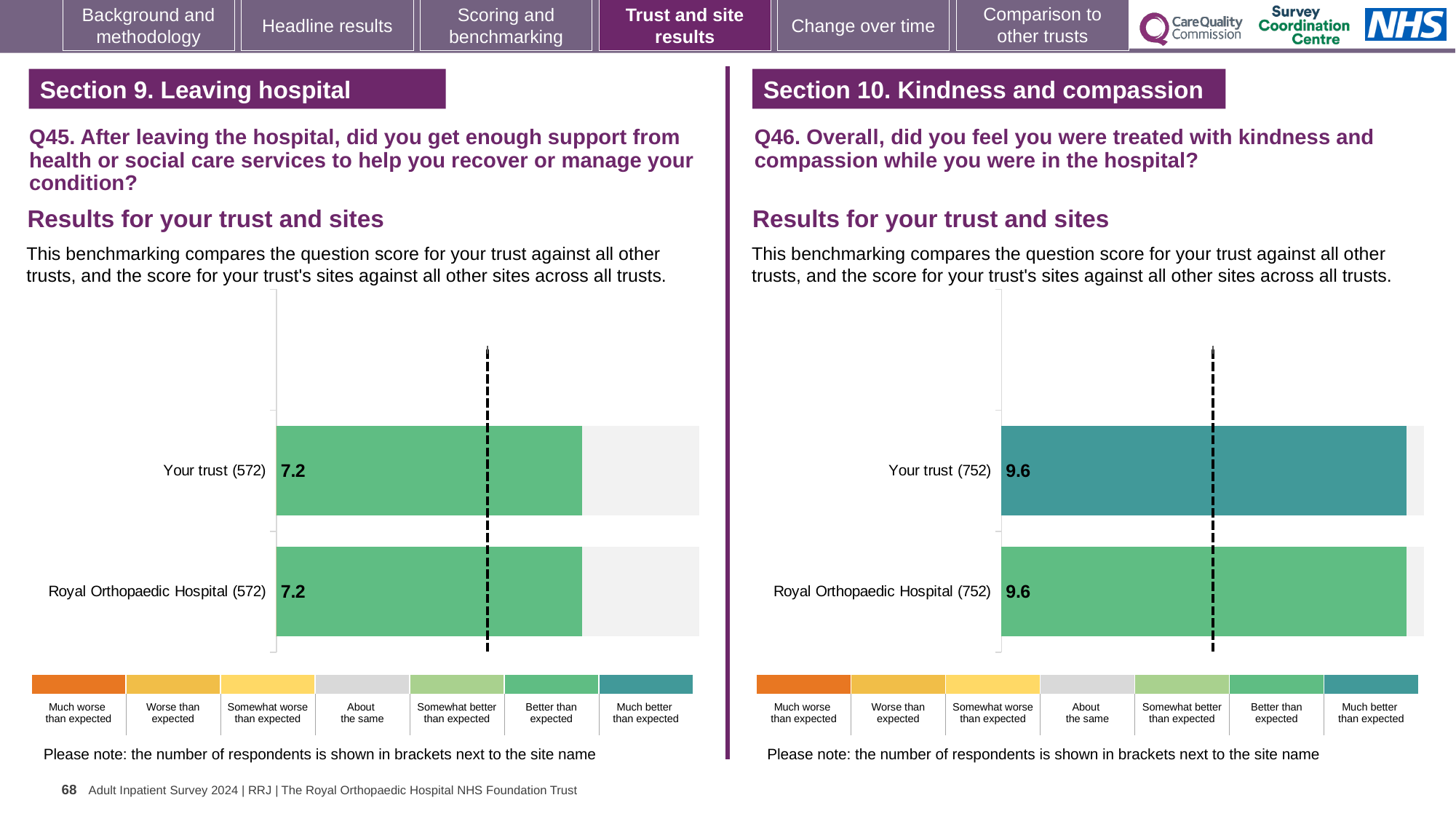
In the Q45 chart on the left, what is the score for Your trust (572)? 7.2 In the Q45 chart on the left, what is the score for Royal Orthopaedic Hospital (572)? 7.2 In the Q45 chart on the left, how many respondents are shown in brackets next to Royal Orthopaedic Hospital? 572 How many bars are plotted in the Q46 chart on the right? 2 In the Q46 chart on the right, how many respondents are shown in brackets next to Your trust? 752 How many bars are plotted in the Q45 chart on the left? 2 In the Q46 chart on the right, what is the score for Your trust (752)? 9.6 In the Q45 chart on the left, what is the difference between the score for Your trust and the score for Royal Orthopaedic Hospital? 0 According to the colour key, which benchmark category does the bar colour in the Q46 chart on the right for Your trust (752) represent? Much better than expected In the Q46 chart on the right, what is the score for Royal Orthopaedic Hospital (752)? 9.6 What kind of chart is used for the Q45 results on the left? Bar chart How many benchmark categories does the colour key below the Q46 chart on the right list? 7